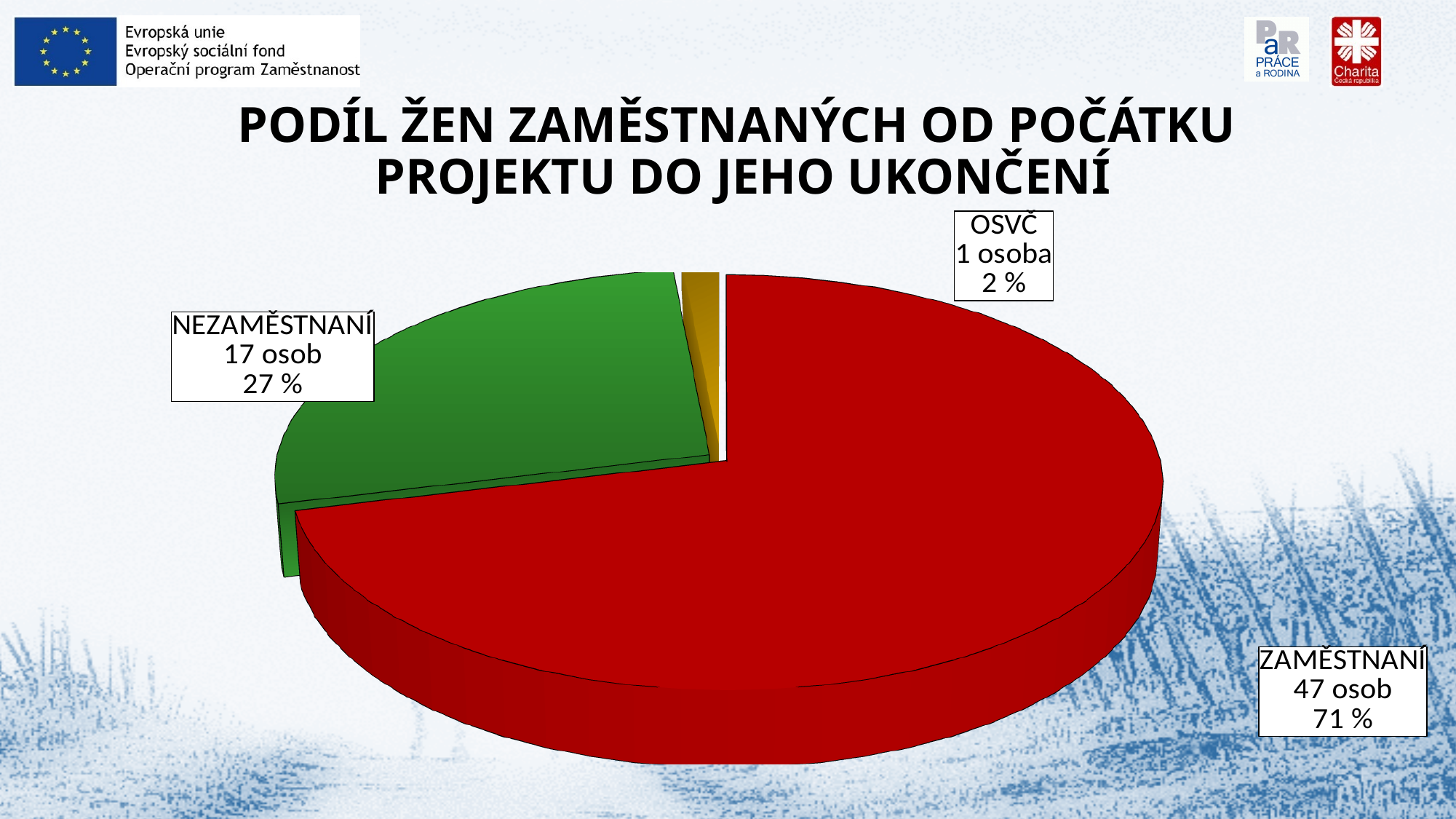
What share of the pie does the NEZAMĚSTNANÍ slice represent? 27 % Which category has the smallest slice of the pie? OSVČ What is the difference in the number of people between ZAMĚSTNANÍ and NEZAMĚSTNANÍ? 30 What share of the pie does the OSVČ slice represent? 2 % How many people are in the NEZAMĚSTNANÍ category? 17 osob How many people are in the OSVČ category? 1 osoba What colour is the ZAMĚSTNANÍ slice? Red What share of the pie does the ZAMĚSTNANÍ slice represent? 71 % Which category has the largest slice of the pie? ZAMĚSTNANÍ How many slices does the pie chart have? 3 How many people are in the ZAMĚSTNANÍ category? 47 osob What kind of chart is shown on the slide? Pie chart